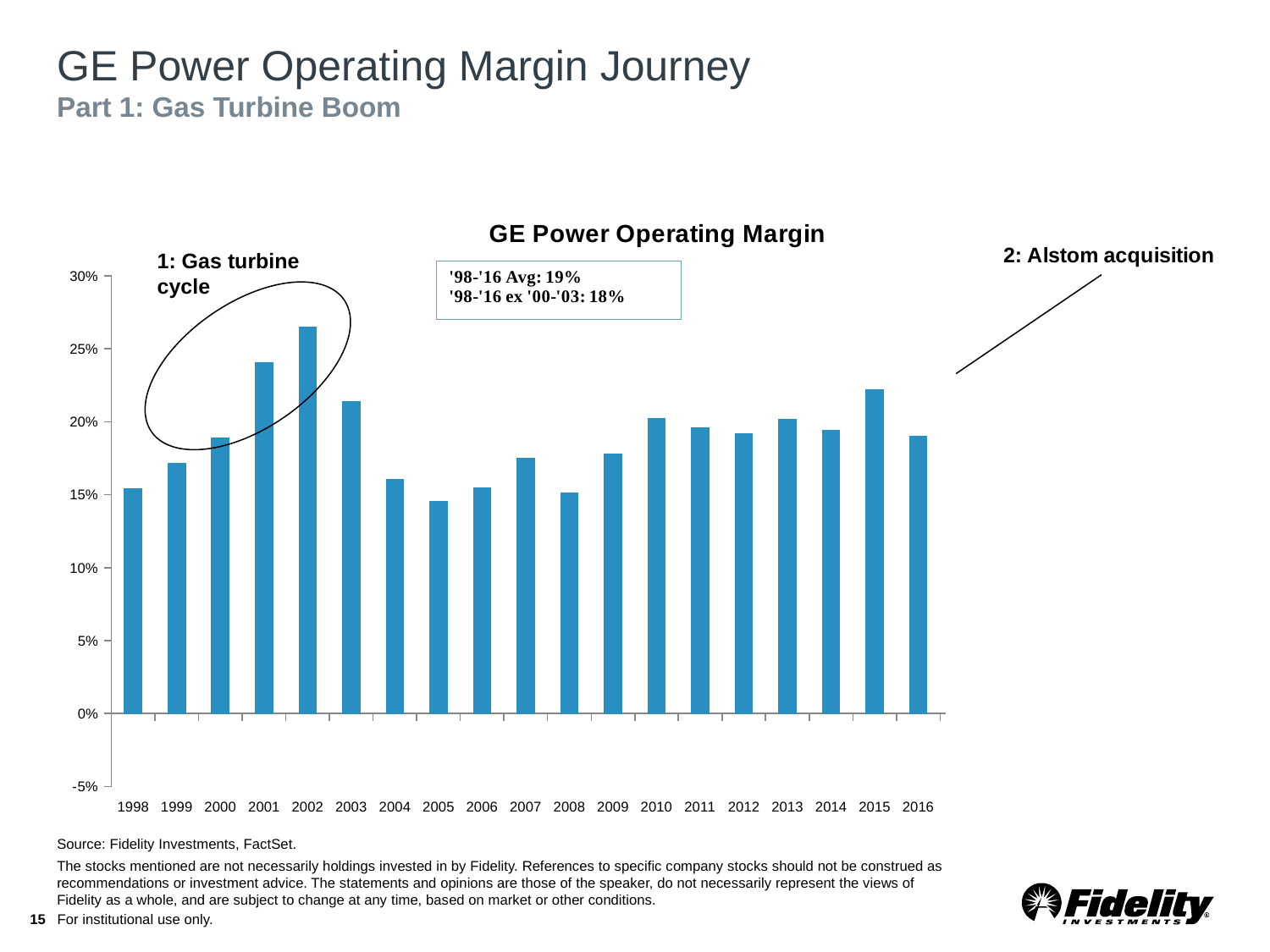
Which year has the larger operating margin, 2001 or 2003? 2001 How many years are plotted on the x axis of the chart? 19 Do the operating margin values rise or fall from 1998 to 2002? rise Is the operating margin for 2005 greater or less than 15%? less According to the text box on the chart, what is the '98-'16 average operating margin? 19% Which year has the highest GE Power operating margin? 2002 Is the operating margin for 2002 greater or less than 25%? greater What is the title of the chart? GE Power Operating Margin Which year has the lowest GE Power operating margin? 2005 Is the operating margin for 2015 greater or less than 20%? greater What kind of chart is shown on the slide? bar chart